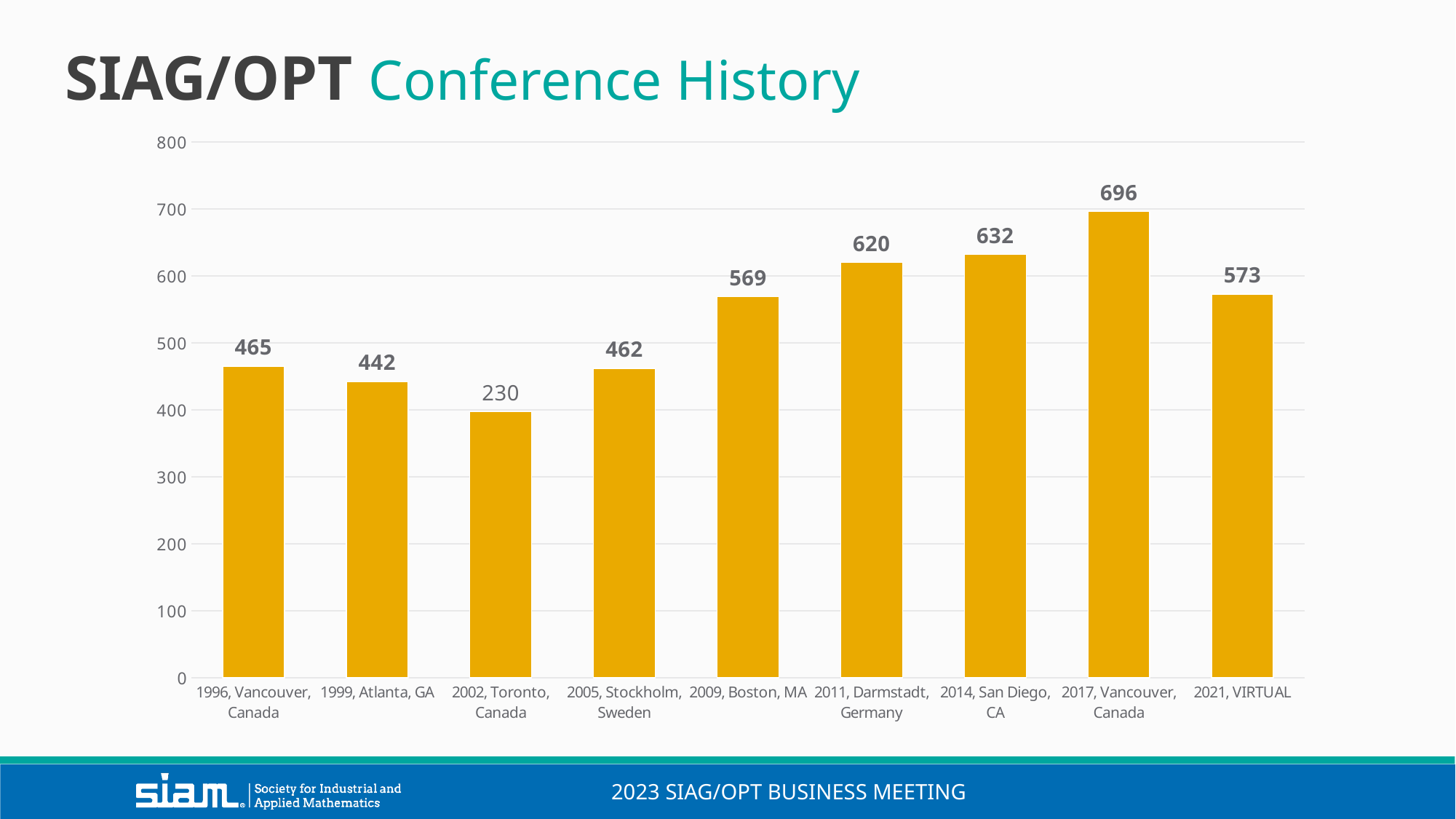
Which conference has the lowest value? 2002, Toronto, Canada What is the value for the 2021, VIRTUAL conference? 573 What is the title of the slide containing the chart? SIAG/OPT Conference History What is the value for the 2017, Vancouver, Canada conference? 696 What is the value for the 2011, Darmstadt, Germany conference? 620 Which is larger, the value for 1996, Vancouver, Canada or 1999, Atlanta, GA? 1996, Vancouver, Canada Which conference has the highest value? 2017, Vancouver, Canada Is the value for 2014, San Diego, CA greater or less than 600? greater What is the difference between the values for 2017, Vancouver, Canada and 2021, VIRTUAL? 123 What kind of chart is shown on the slide? bar chart What is the difference between the values for 2009, Boston, MA and 2005, Stockholm, Sweden? 107 How many conferences (bars) are shown in the chart? 9